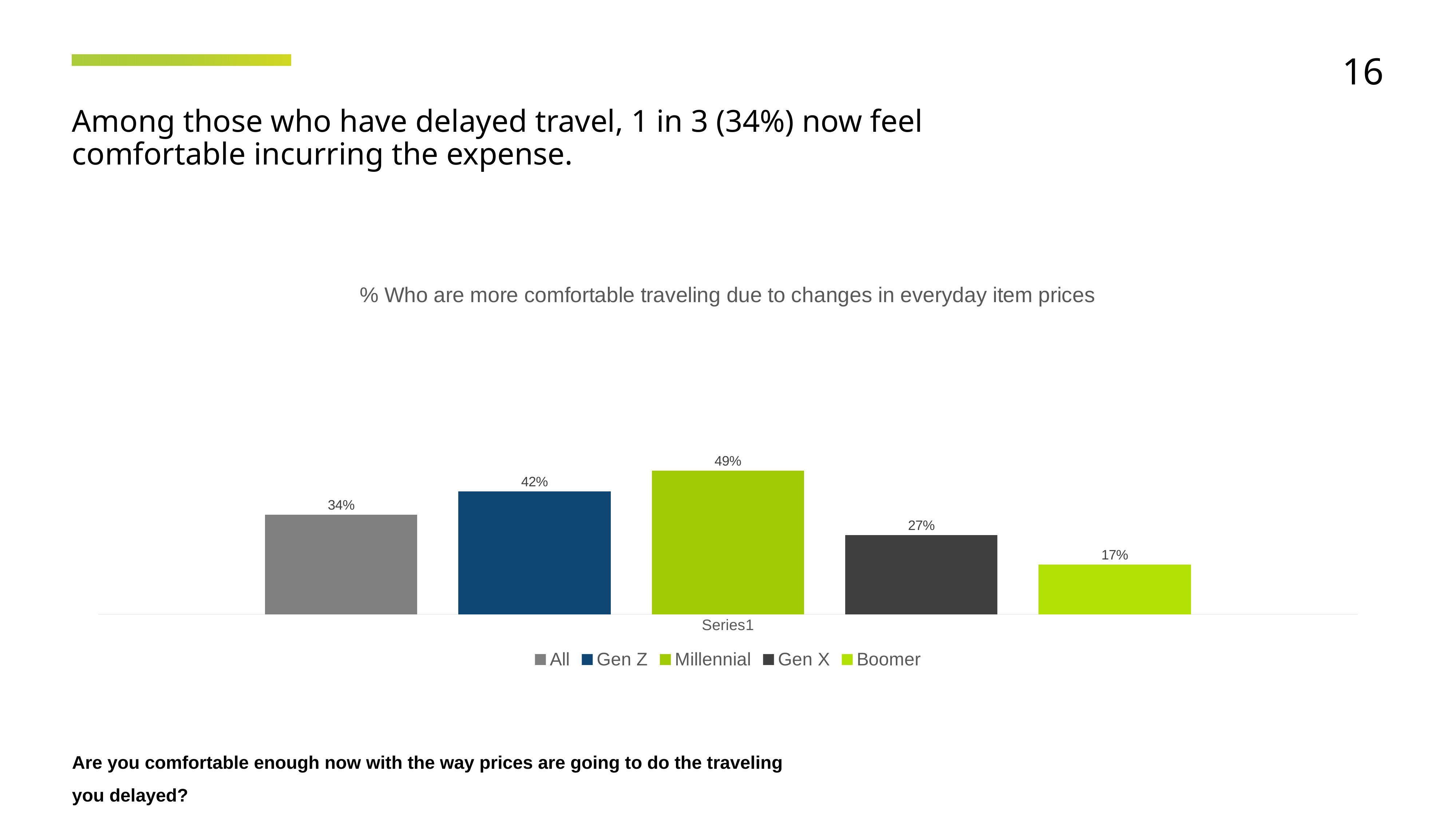
What is the value for Boomer? 17% What is the difference between the Millennial and Gen X values? 22% What is the title of the chart? % Who are more comfortable traveling due to changes in everyday item prices What is the value for Millennial? 49% Which group has the lowest value? Boomer What is the value for All? 34% Which group has the highest value? Millennial What kind of chart is shown? Bar chart Which is larger, the value for Gen X or the value for Boomer? Gen X What is the value for Gen Z? 42% How many series does the legend list? 5 What is the difference between the Gen Z and All values? 8%